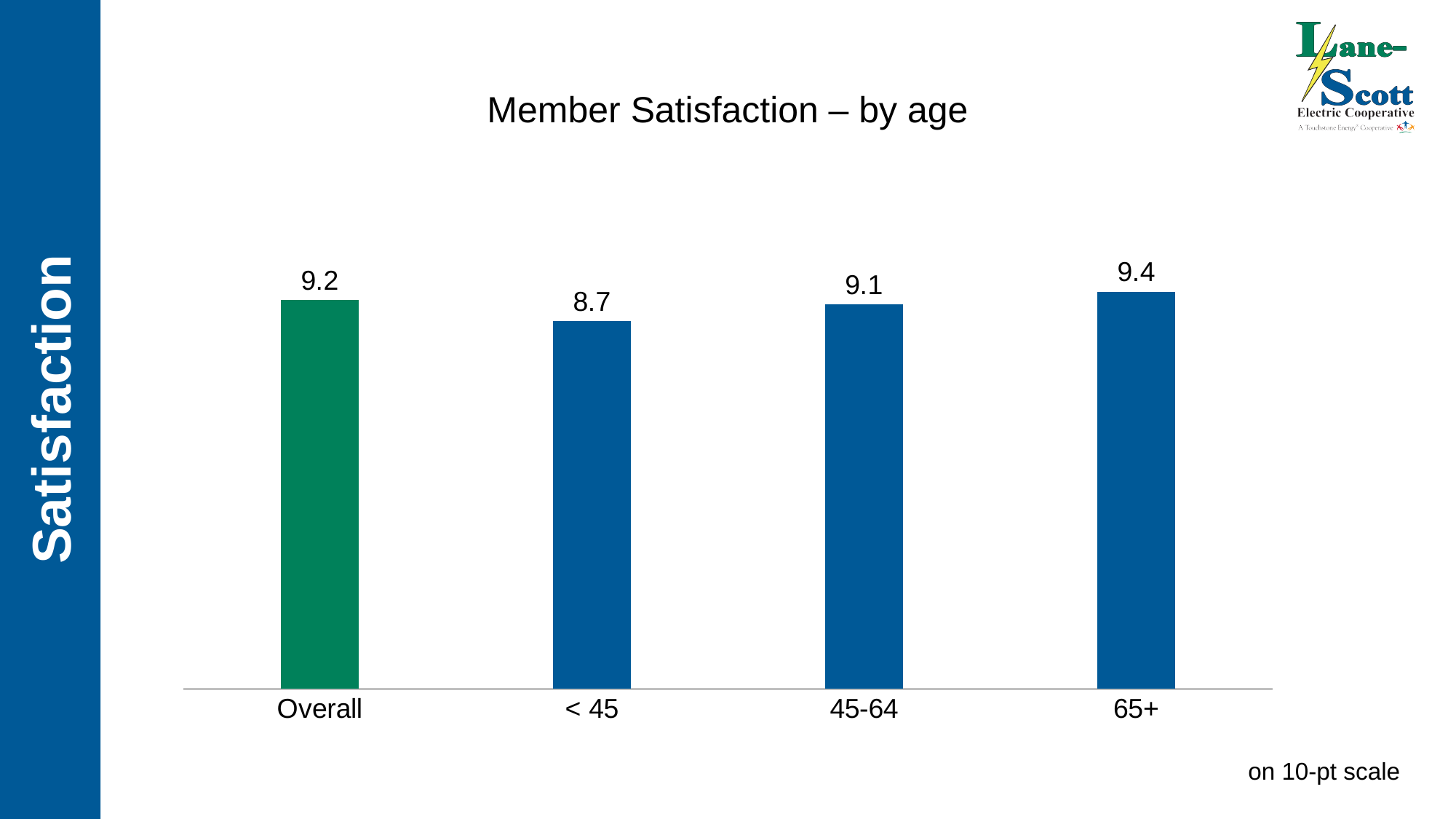
What kind of chart is shown on the slide? Bar chart What is the satisfaction value for the 45-64 age group? 9.1 Which has a higher satisfaction value, < 45 or 45-64? 45-64 Which category has the highest satisfaction value? 65+ What is the satisfaction value for the < 45 age group? 8.7 What is the satisfaction value for the 65+ age group? 9.4 How many categories are shown on the chart? 4 Which category has the lowest satisfaction value? < 45 What is the title of the chart? Member Satisfaction – by age What is the difference between the Overall satisfaction value and the value for 45-64? 0.1 What is the satisfaction value for the Overall category? 9.2 What is the difference between the satisfaction values for 65+ and < 45? 0.7